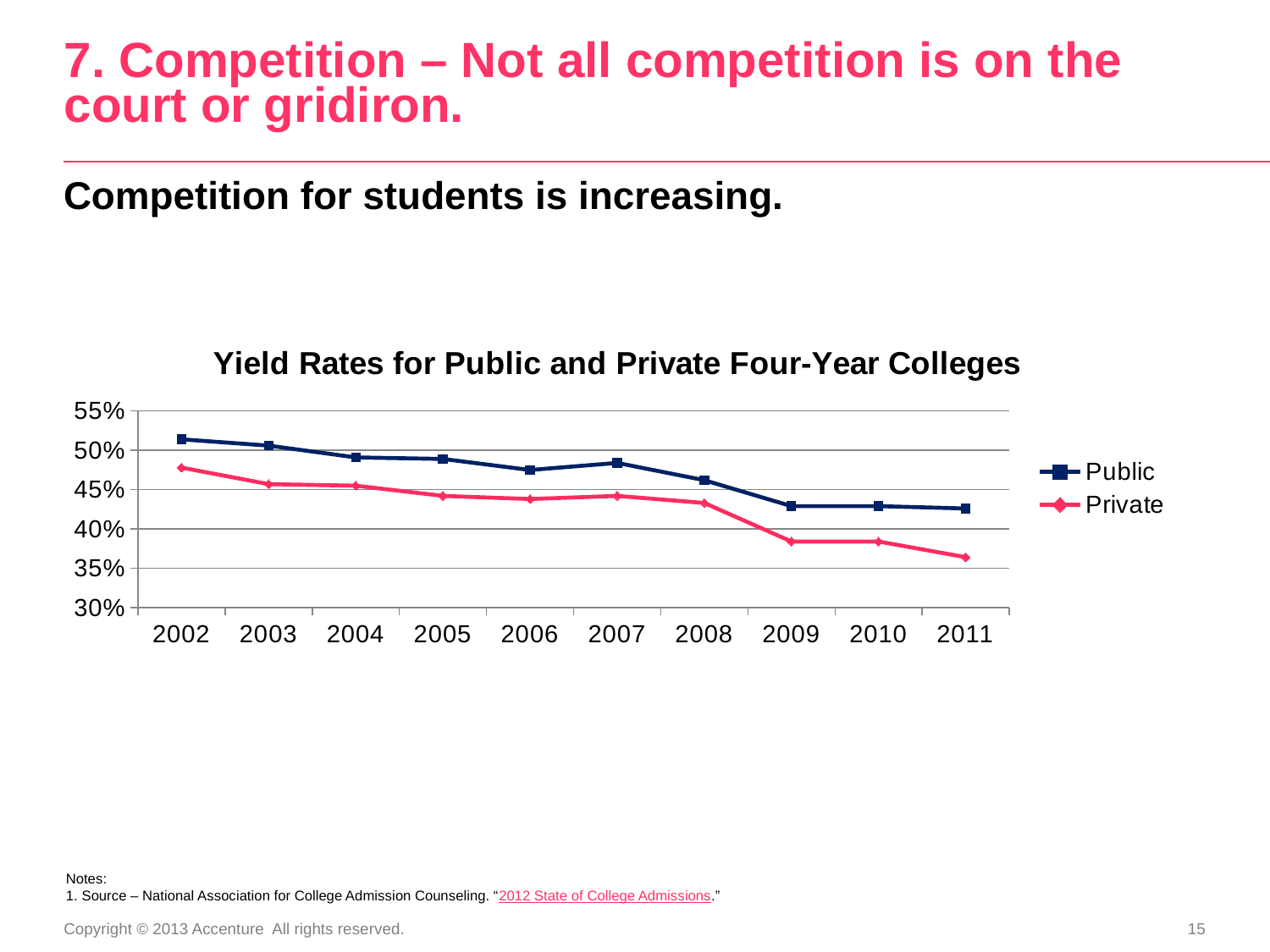
How many years are plotted along the x axis? 10 In which year is the Private yield rate lowest? 2011 Do the Private yield rates generally rise or fall from 2002 to 2011? fall Is the Public yield rate in 2002 greater or less than 50%? greater Which series is drawn in red? Private Is the Private yield rate in 2011 greater or less than 40%? less What kind of chart is shown on the slide? line chart In 2009, which series has the higher yield rate, Public or Private? Public In which year is the Public yield rate highest? 2002 What is the title of the chart? Yield Rates for Public and Private Four-Year Colleges Do the Public yield rates generally rise or fall from 2002 to 2011? fall How many series does the legend list? 2